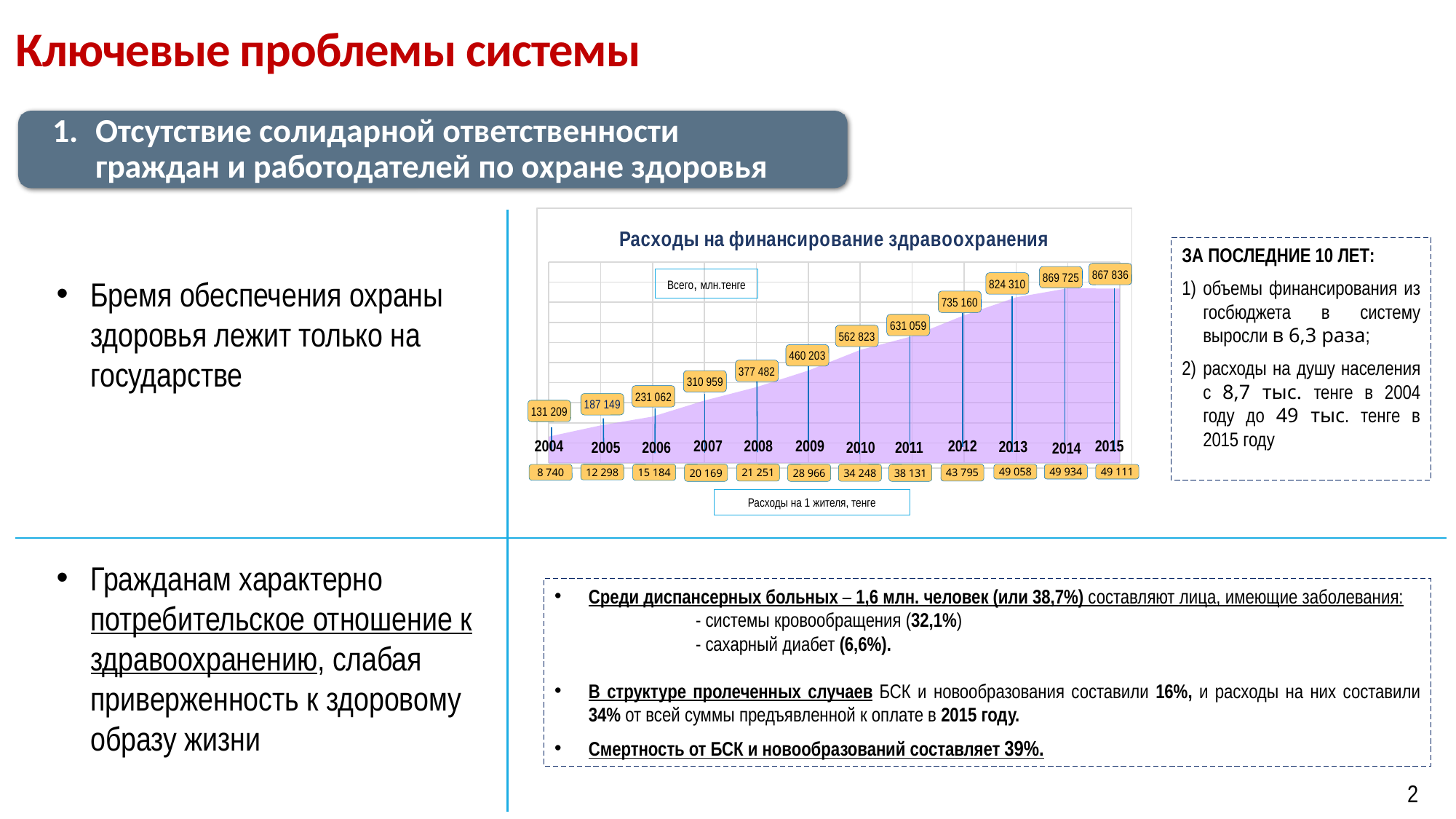
Which year has the highest total healthcare financing (Всего, млн.тенге)? 2014 Which year has the larger total healthcare financing, 2010 or 2011? 2011 By how much did total healthcare financing (Всего, млн.тенге) increase from 2004 to 2015? 736 627 Which year has the lowest per-capita expenditure (Расходы на 1 жителя, тенге)? 2004 What is the per-capita expenditure (Расходы на 1 жителя, тенге) for 2009? 28 966 How many years are shown on the x axis of the chart? 12 What is the total healthcare financing (Всего, млн.тенге) for 2004? 131 209 What kind of chart is used to show the healthcare financing expenditures? Area chart What is the total healthcare financing (Всего, млн.тенге) for 2012? 735 160 What is the overall trend of total healthcare financing from 2004 to 2014? Rising What is the title of the chart on the slide? Расходы на финансирование здравоохранения What is the per-capita expenditure (Расходы на 1 жителя, тенге) for 2015? 49 111